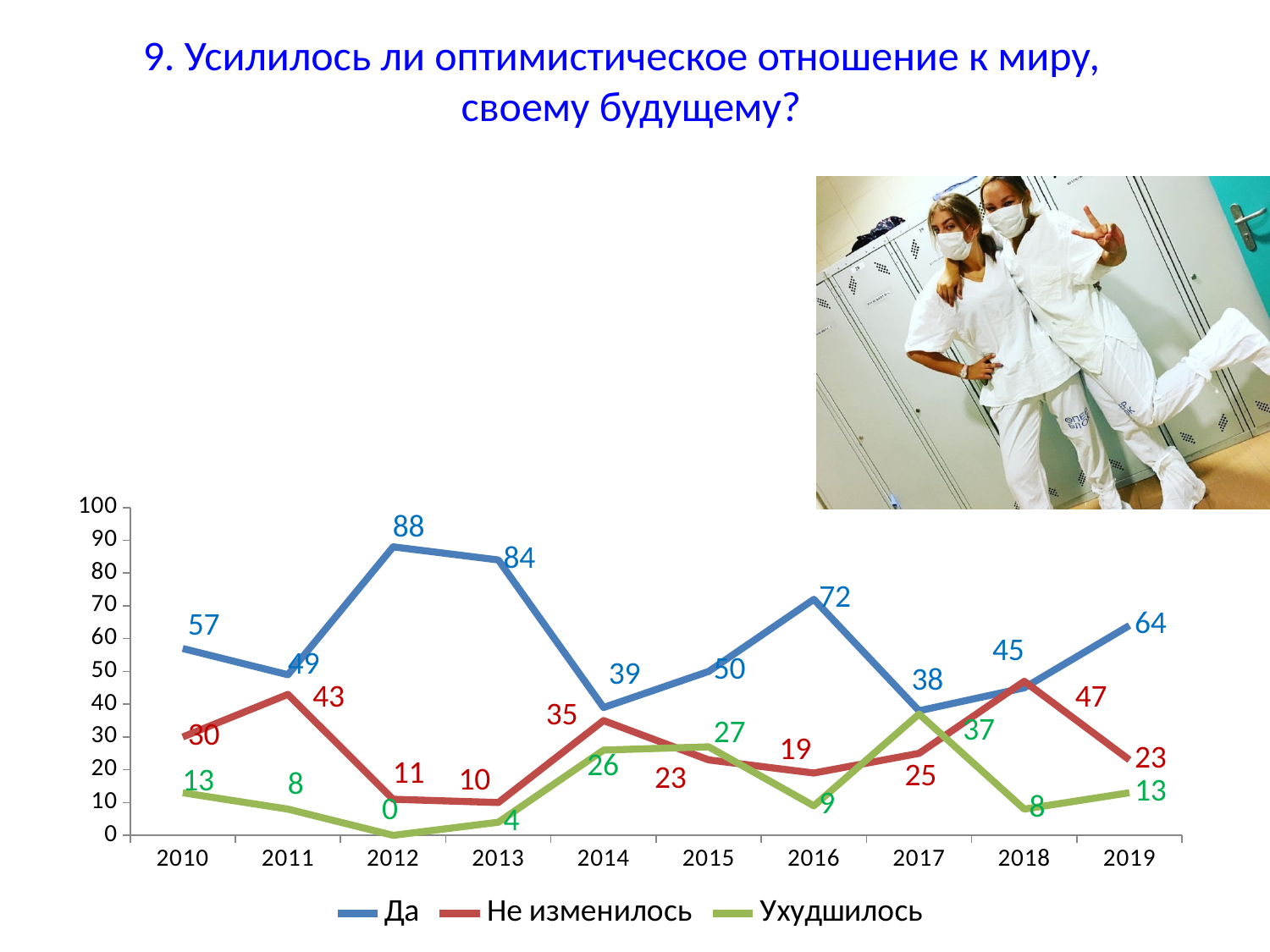
What type of chart is shown on the slide? line chart How many years are shown on the x axis? 10 In which year does the "Ухудшилось" series have its lowest value? 2012 How many series does the legend list? 3 What colour is the line for the "Ухудшилось" series? green In which year does the "Да" series reach its highest value? 2012 What is the value of the "Ухудшилось" series in 2017? 37 What is the value of the "Не изменилось" series in 2018? 47 What is the difference between the "Да" value in 2012 and the "Да" value in 2017? 50 What is the value of the "Да" series in 2012? 88 Does the "Да" series rise or fall from 2017 to 2019? rise Which is larger in 2018: the "Да" value or the "Не изменилось" value? Не изменилось